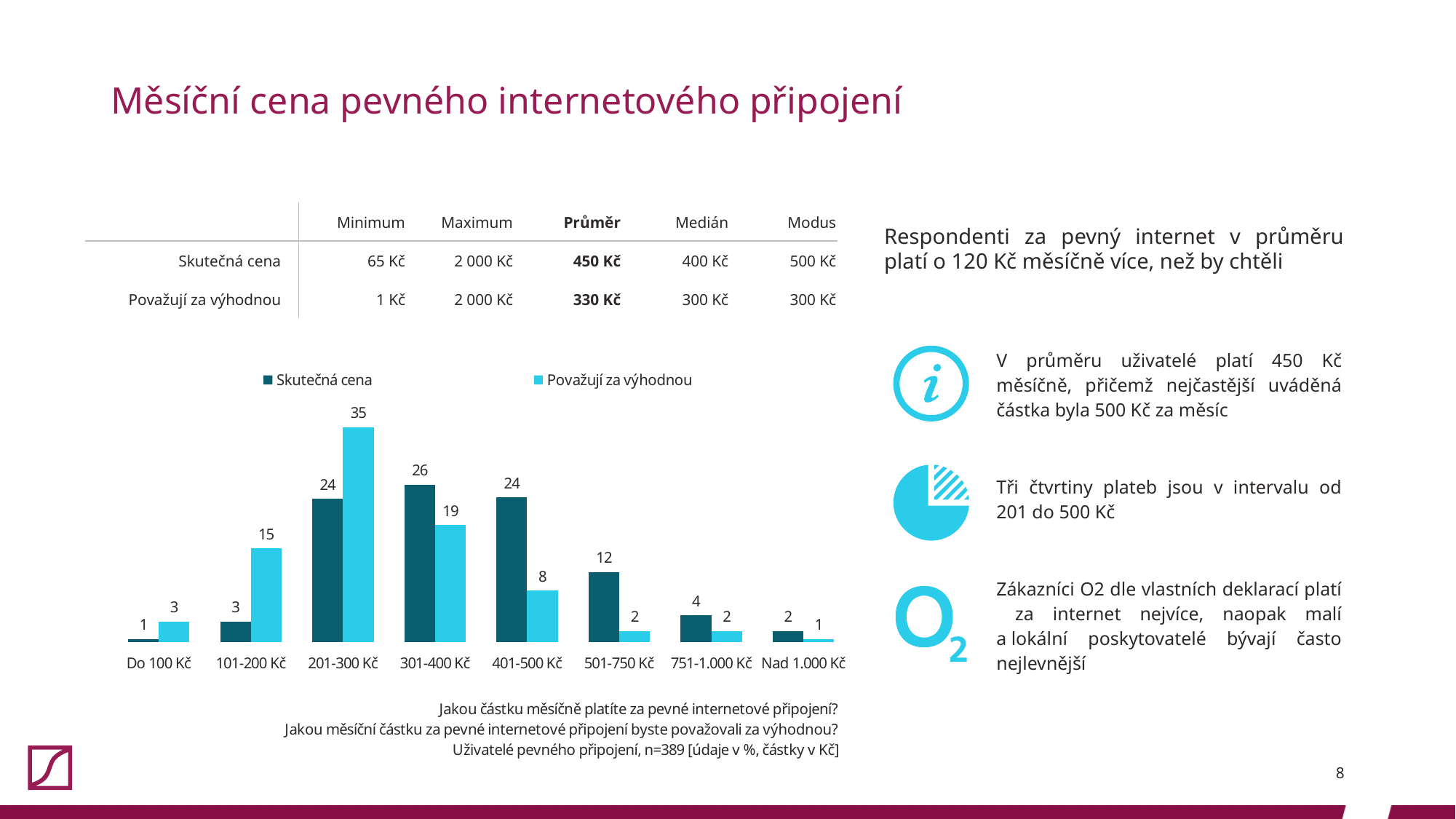
In the 401-500 Kč category, which series has the larger value, Skutečná cena or Považují za výhodnou? Skutečná cena What type of chart is shown on the slide? bar chart What is the value for Skutečná cena in the 301-400 Kč category? 26 What is the difference between Považují za výhodnou and Skutečná cena in the 101-200 Kč category? 12 How many series does the chart legend list? 2 What is the value for Skutečná cena in the 501-750 Kč category? 12 How many categories are shown on the x axis of the chart? 8 Which category has the highest value for Považují za výhodnou? 201-300 Kč What is the value for Považují za výhodnou in the 201-300 Kč category? 35 Which series in the chart is shown in the darker teal colour? Skutečná cena What is the difference between Skutečná cena and Považují za výhodnou in the 401-500 Kč category? 16 Which category has the lowest value for Skutečná cena? Do 100 Kč